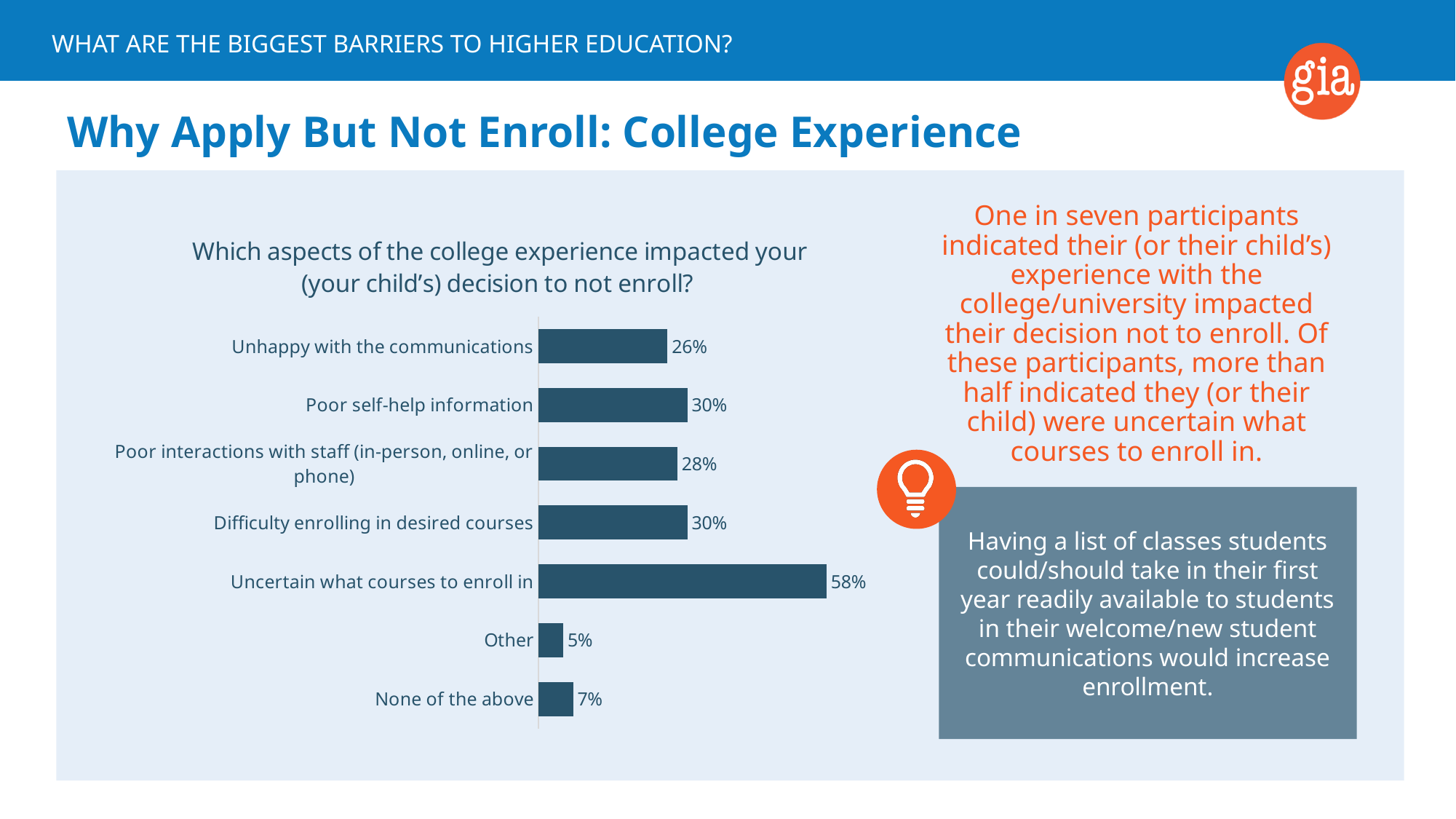
What type of chart is shown on the slide? Bar chart What is the difference between "None of the above" and "Other"? 2% What percentage of respondents selected "Uncertain what courses to enroll in"? 58% Which category has the lowest value? Other Which is larger: "Poor self-help information" or "Unhappy with the communications"? Poor self-help information What question does the chart title ask? Which aspects of the college experience impacted your (your child's) decision to not enroll? What is the difference between "Uncertain what courses to enroll in" and "Poor self-help information"? 28% What percentage is shown for "Poor interactions with staff (in-person, online, or phone)"? 28% How many categories are shown in the chart? 7 What is the value for "None of the above"? 7% What is the value for "Unhappy with the communications"? 26% Which category has the highest value? Uncertain what courses to enroll in